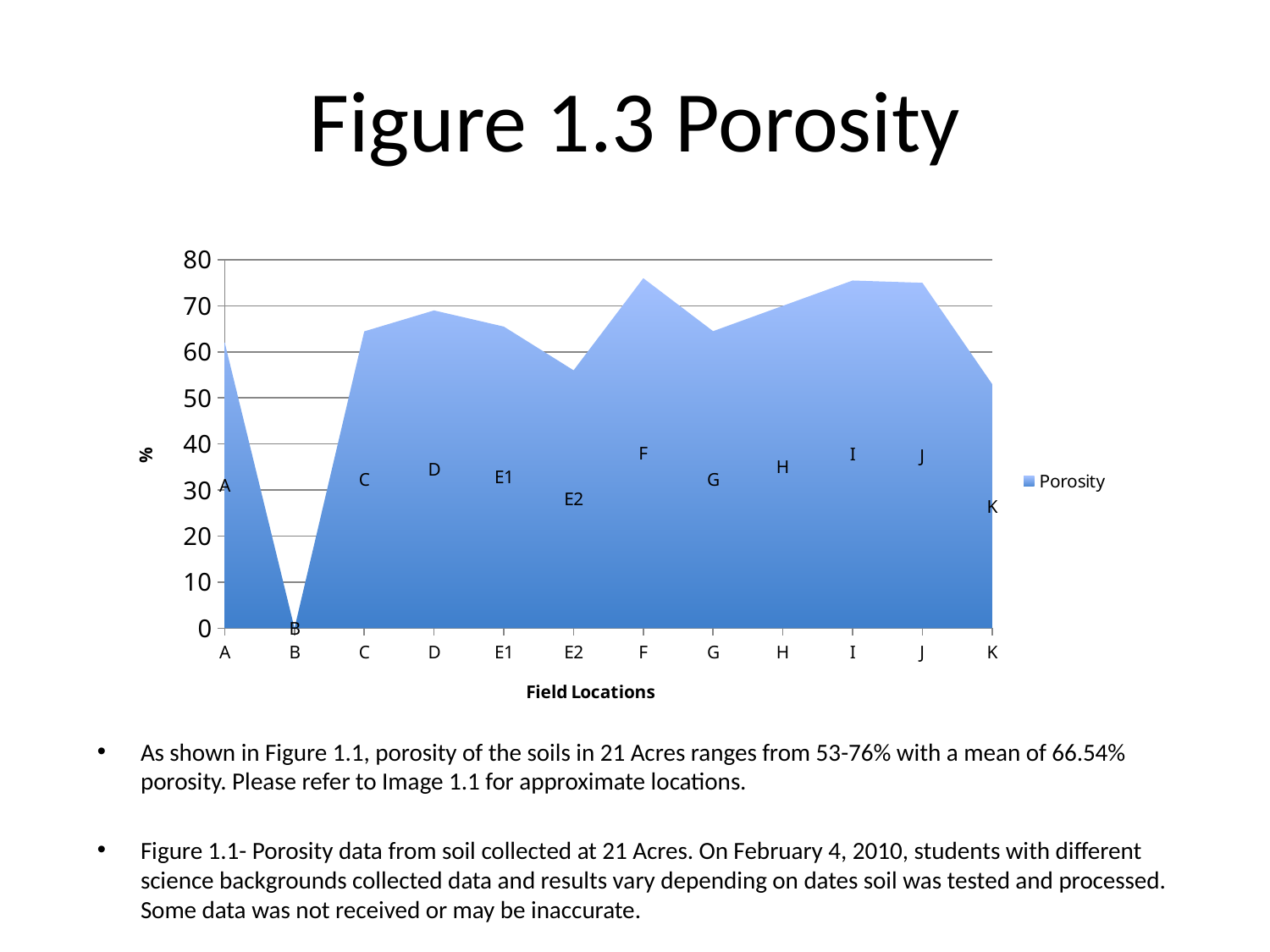
Which has a higher porosity value, field location D or field location E2? D What is the name of the series shown in the legend? Porosity Do the porosity values rise or fall from field location I to field location K? fall What kind of chart is shown on the slide? area chart Which field location has the lowest porosity value? B How many field locations are plotted along the x axis? 12 How many series does the legend list? 1 Is the porosity value for field location A greater or less than 50? greater What is the porosity value for field location B? 0 Is the porosity value for field location E2 greater or less than 60? less Is the porosity value for field location F greater or less than 70? greater What is the title of the x axis? Field Locations